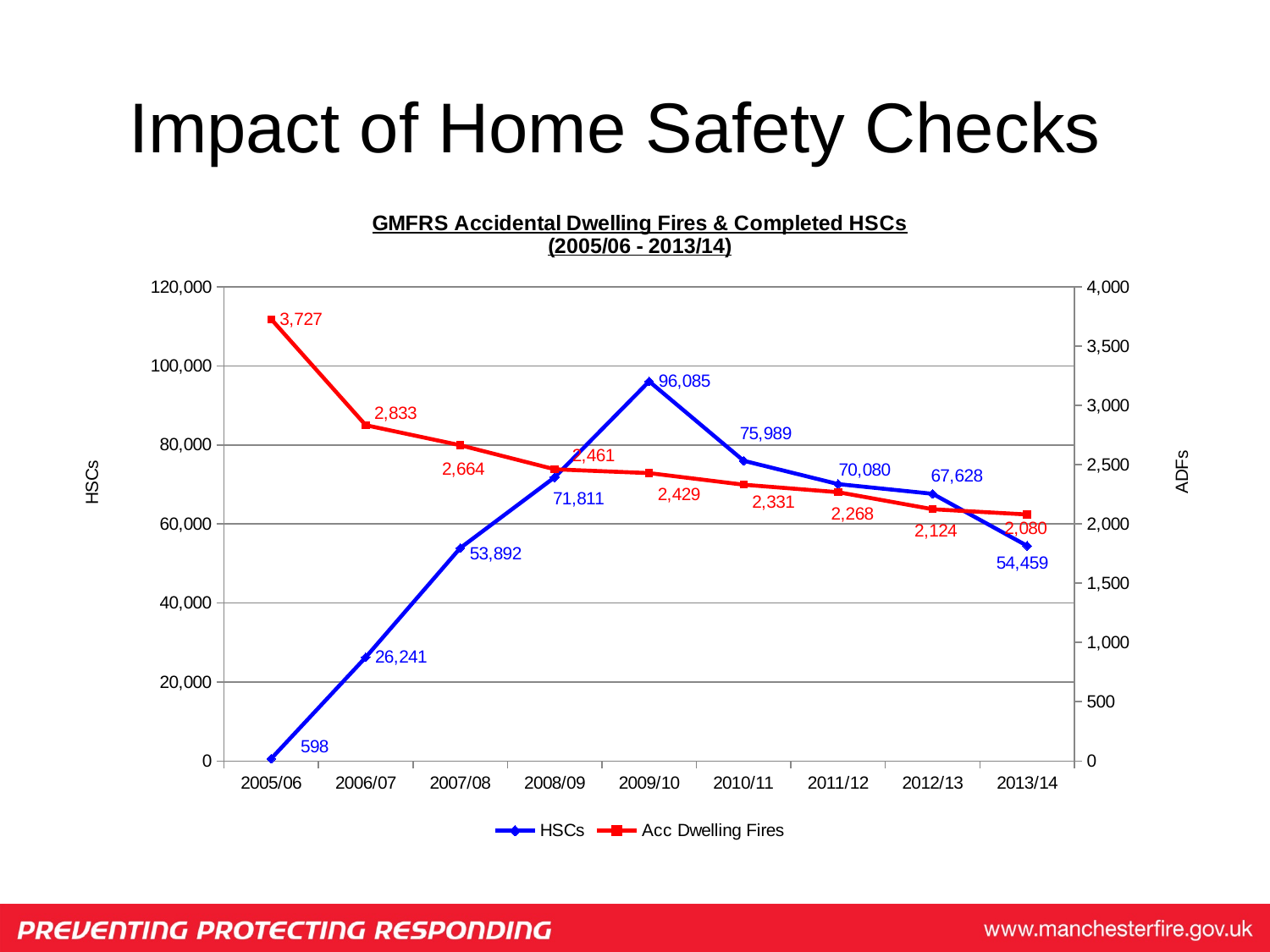
Do the Acc Dwelling Fires values rise or fall from 2005/06 to 2013/14? fall What type of chart is shown on the slide? line chart In which year is the HSCs value highest? 2009/10 Which year has the larger HSCs value, 2006/07 or 2007/08? 2007/08 How many years are plotted along the x axis? 9 What is the value of Acc Dwelling Fires in 2005/06? 3,727 What is the value of HSCs in 2009/10? 96,085 What is the value of HSCs in 2013/14? 54,459 What is the title of the chart? GMFRS Accidental Dwelling Fires & Completed HSCs (2005/06 - 2013/14) What is the difference between Acc Dwelling Fires in 2005/06 and 2013/14? 1,647 In which year is the Acc Dwelling Fires value lowest? 2013/14 How many series does the legend list? 2